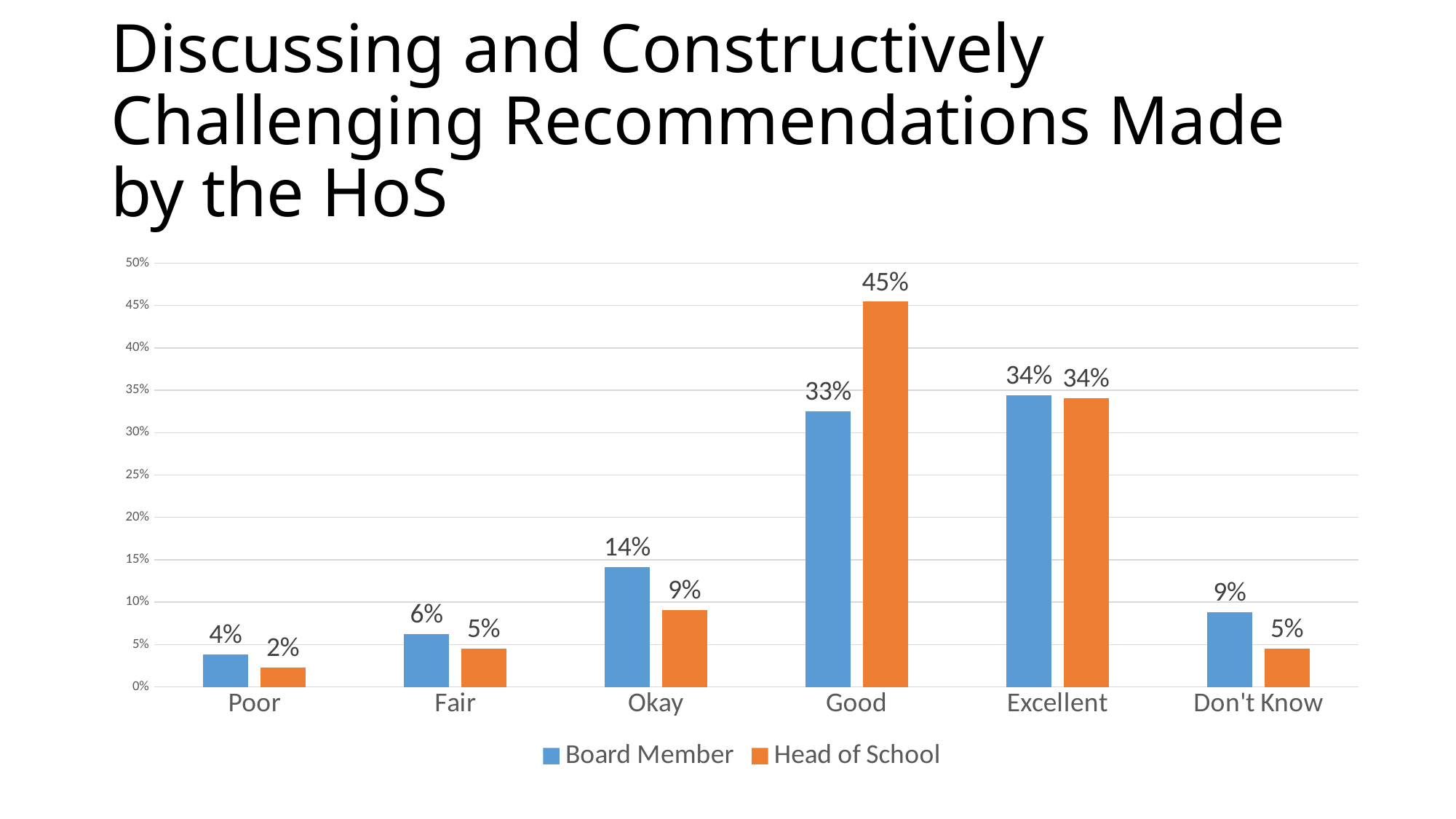
What is the Board Member value for Don't Know? 9% What kind of chart is shown on the slide? Bar chart Is the Board Member value for Excellent greater or less than 30%? greater Which category has the highest Head of School value? Good How many categories are shown on the x axis? 6 How many series does the legend list? 2 Which colour represents the Head of School series? Orange What is the Head of School value for Good? 45% What is the Board Member value for Okay? 14% What is the difference between the Head of School and Board Member values for Good? 12% Which is larger for Okay: the Board Member value or the Head of School value? Board Member Which category has the lowest Board Member value? Poor